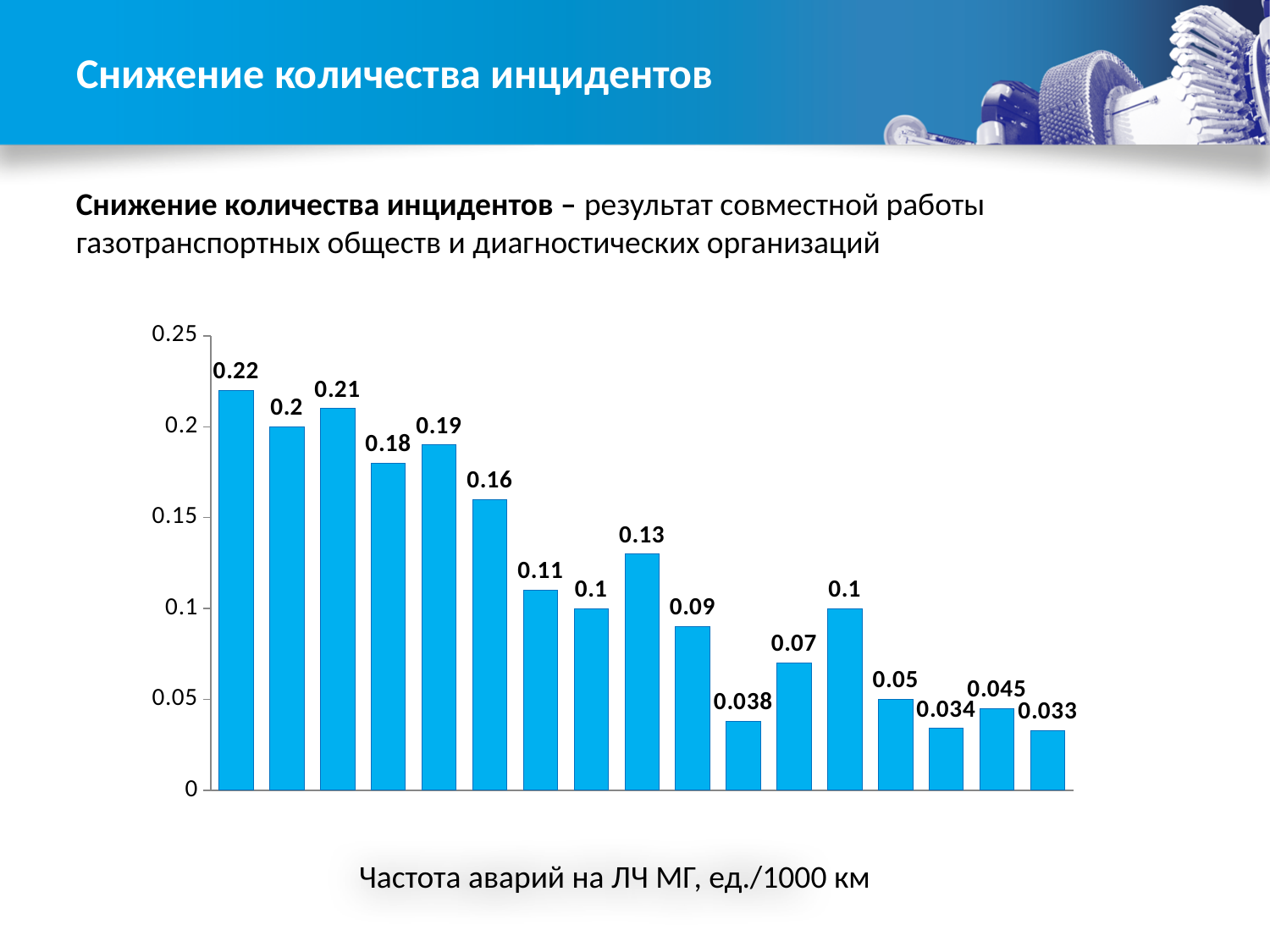
What is the highest tick value shown on the vertical axis? 0.25 Is the value of the sixth bar from the left greater or less than 0.15? greater What caption is printed below the chart? Частота аварий на ЛЧ МГ, ед./1000 км Do the bar values generally rise or fall from left to right across the chart? fall What is the highest value labelled on any bar in the chart? 0.22 What is the value shown on the first (leftmost) bar of the chart? 0.22 How many bars are plotted in the chart? 17 What is the difference between the first bar's value (0.22) and the last bar's value (0.033)? 0.187 Which is larger: the value of the third bar from the left or the value of the second bar from the left? the third bar (0.21) What kind of chart is shown on the slide? bar chart What is the value shown on the last (rightmost) bar of the chart? 0.033 What is the lowest value labelled on any bar in the chart? 0.033